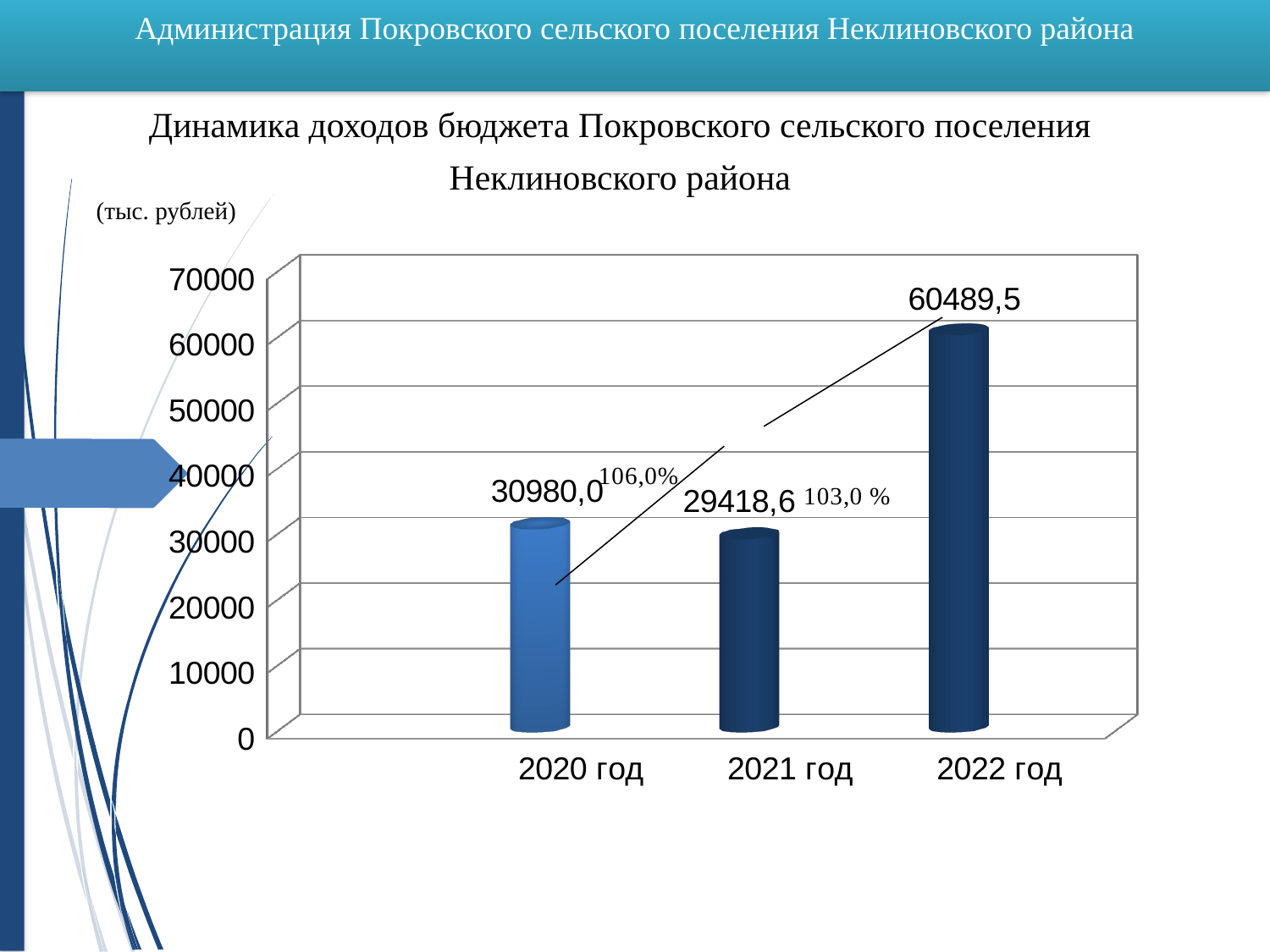
Which year has the lowest value? 2021 год How many years are shown on the chart? 3 Which is larger, the value for 2020 год or the value for 2021 год? 2020 год Which year has the highest value? 2022 год What is the value for 2020 год? 30980,0 What is the value for 2021 год? 29418,6 What is the difference between the values for 2020 год and 2021 год? 1561,4 What is the difference between the values for 2022 год and 2020 год? 29509,5 In what units are the values on the chart given? тыс. рублей What kind of chart is shown on the slide? bar chart What is the value for 2022 год? 60489,5 Is the value for 2022 год greater or less than 50000? greater